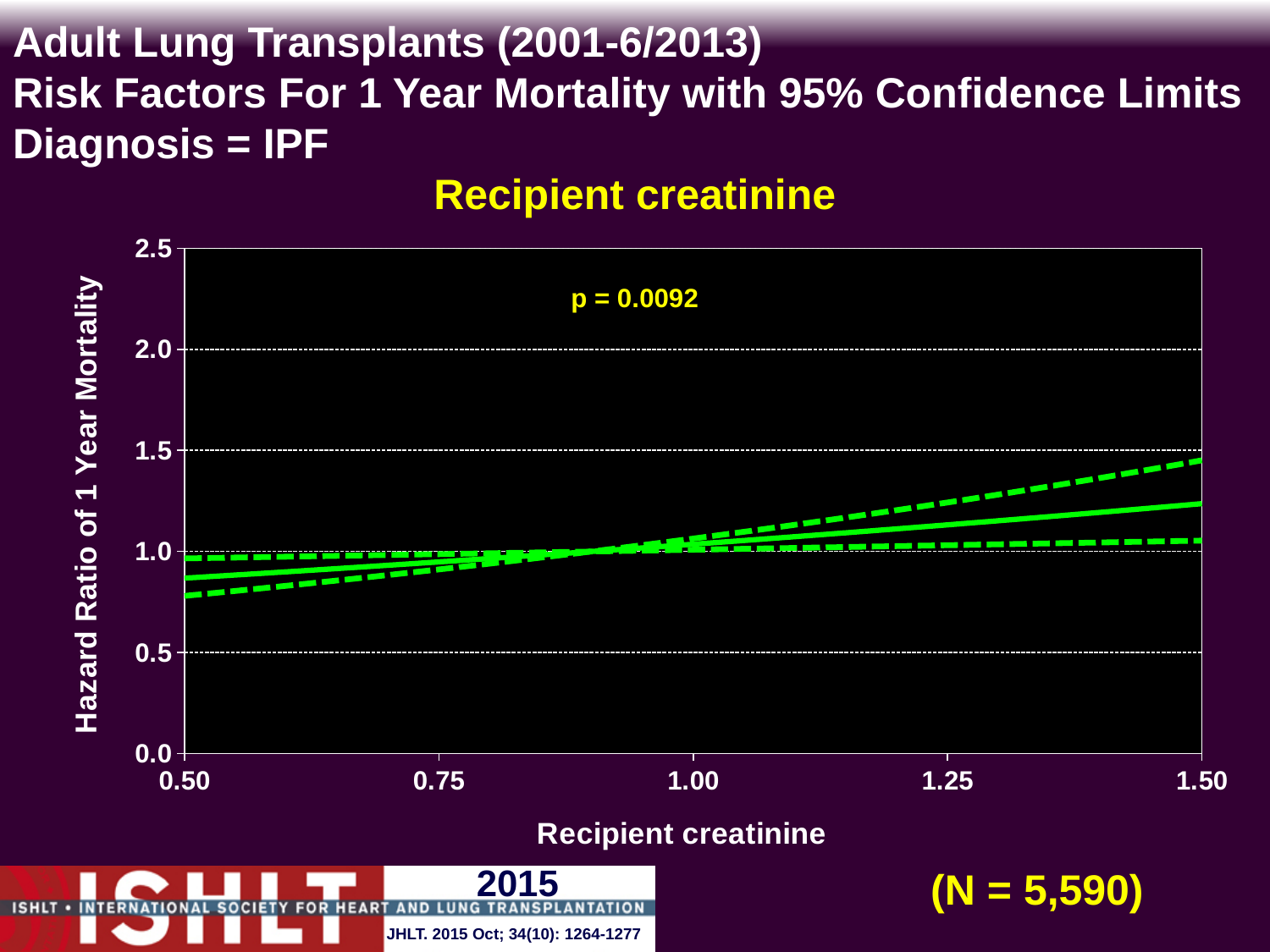
Is the hazard ratio at a recipient creatinine of 1.50 greater or less than 1.5? less Which has the larger hazard ratio: a recipient creatinine of 0.50 or 1.50? 1.50 What kind of chart is shown on the slide? line chart Is the upper 95% confidence limit at a recipient creatinine of 1.50 greater or less than 1.5? less What is the sample size (N) shown on the slide? N = 5,590 Is the hazard ratio at a recipient creatinine of 0.50 greater or less than 1.0? less How many lines are plotted on the chart? 3 Does the hazard ratio of 1 year mortality rise or fall as recipient creatinine increases from 0.50 to 1.50? rise What p-value is shown on the chart? p = 0.0092